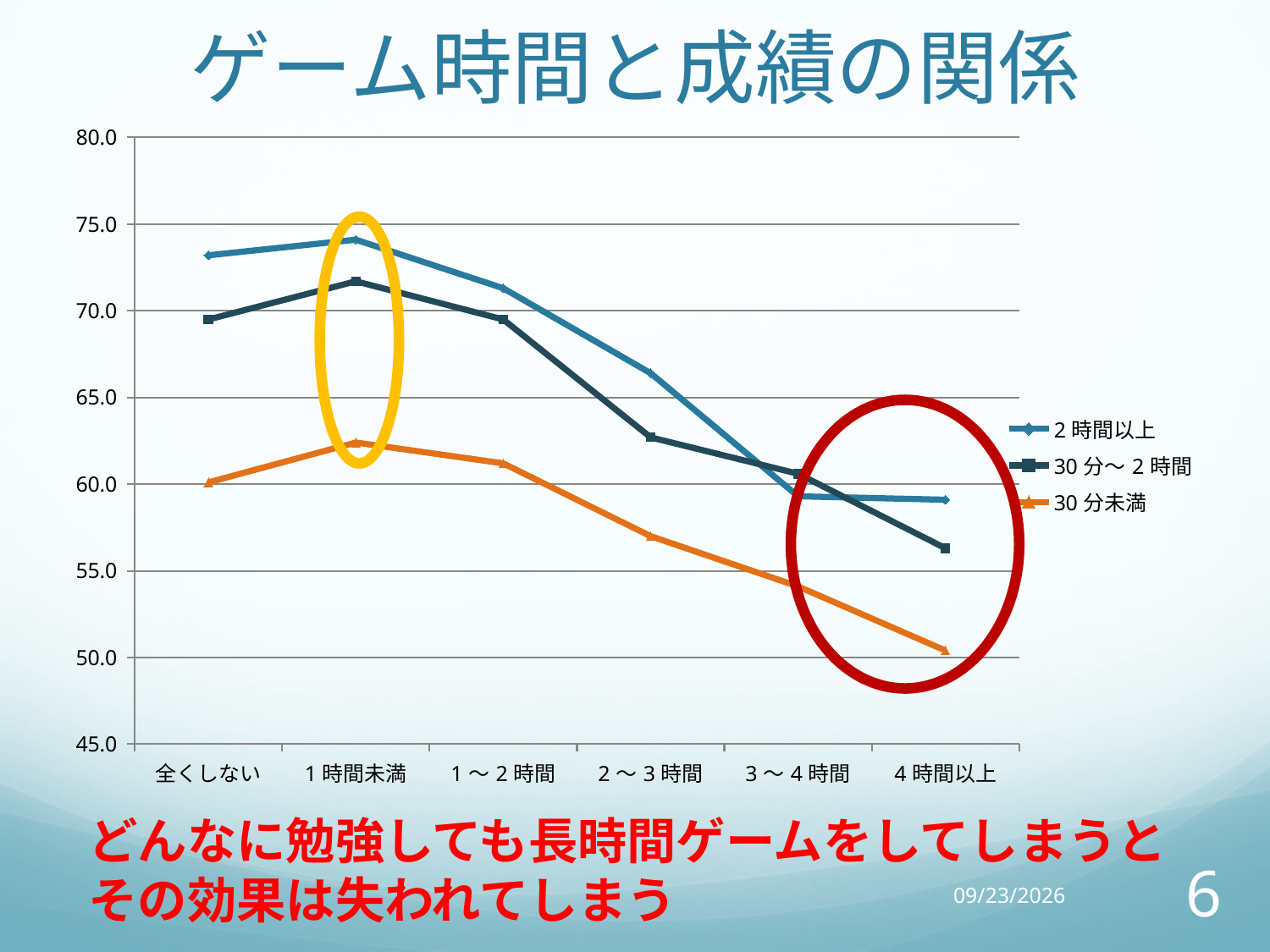
At 全くしない, which series has the highest value? 2 時間以上 Is the value for 2 時間以上 at 全くしない greater or less than 70? greater For the 2 時間以上 series, which category has the highest value? 1 時間未満 How many series does the legend list? 3 Is the value for 30 分未満 at 4 時間以上 greater or less than 55? less For the 30 分未満 series, which category has the lowest value? 4 時間以上 At 4 時間以上, which is larger: the value for 2 時間以上 or the value for 30 分未満? 2 時間以上 Which series is drawn in orange according to the legend? 30 分未満 What is the title of the chart? ゲーム時間と成績の関係 How many categories are shown on the x axis? 6 From 1 時間未満 to 4 時間以上, do the values for the 30 分未満 series rise or fall? fall What kind of chart is shown on the slide? line chart